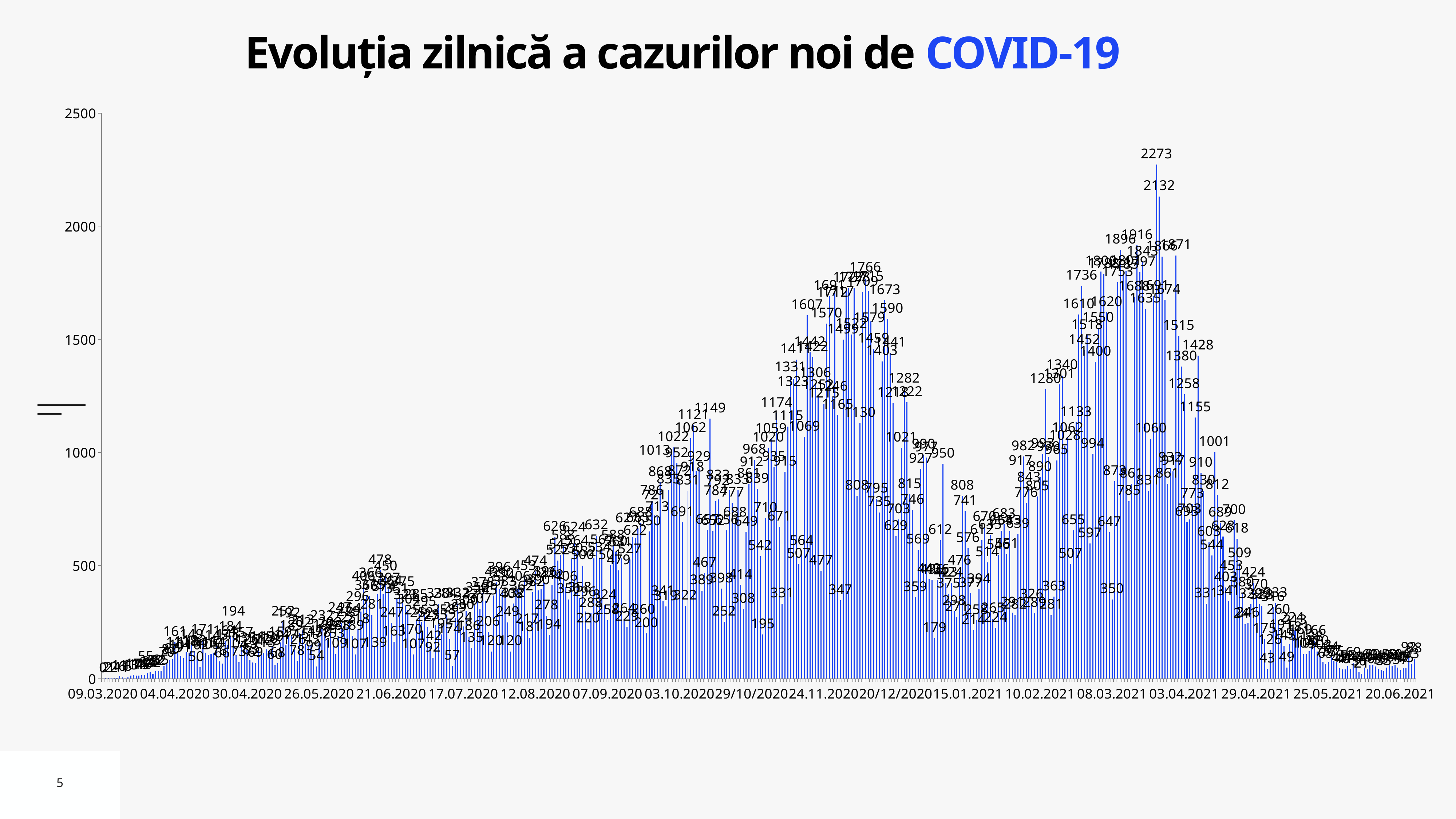
What is the title of the chart? Evoluția zilnică a cazurilor noi de COVID-19 What is the difference between the two highest labelled values, 2273 and 2132? 141 Are the values at the start of the chart, in March 2020, greater or less than 500? less What kind of chart is shown on the slide? bar chart What is the highest daily value shown on the chart? 2273 Do the values generally rise or fall between 09.03.2020 and 21.06.2020? rise What is the second-highest data label shown on the chart, next to the 2273 peak? 2132 What is the last date label on the horizontal axis? 20.06.2021 Is the highest value on the chart greater or less than 2000? greater What is the highest tick value on the vertical axis? 2500 Is the peak of the wave around November 2020 greater or less than 2000? less Do the values rise or fall between 03.04.2021 and 20.06.2021? fall